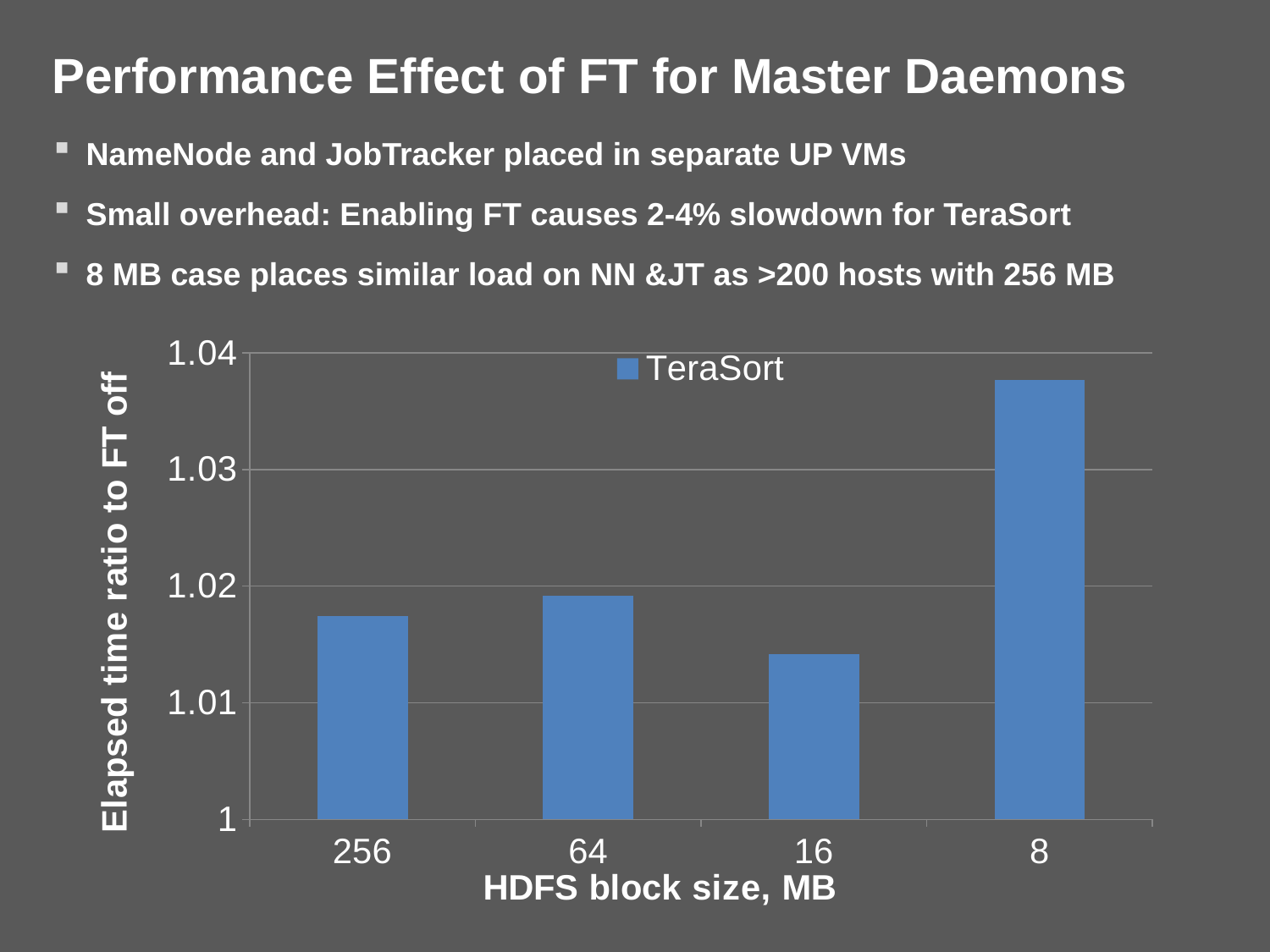
Which has the larger elapsed time ratio, the 8 MB block size or the 256 MB block size? 8 What is the title of the x axis of the chart? HDFS block size, MB Is the elapsed time ratio for the 16 MB block size greater or less than 1.02? less Is the elapsed time ratio for the 256 MB block size greater or less than 1.01? greater What kind of chart is shown on the slide? bar chart How many HDFS block size categories are plotted on the x axis? 4 Which has the larger elapsed time ratio, the 64 MB block size or the 16 MB block size? 64 Is the elapsed time ratio for the 8 MB block size greater or less than 1.03? greater Which HDFS block size has the highest elapsed time ratio? 8 How many series does the legend list? 1 Which HDFS block size has the lowest elapsed time ratio? 16 What series name appears in the chart legend? TeraSort